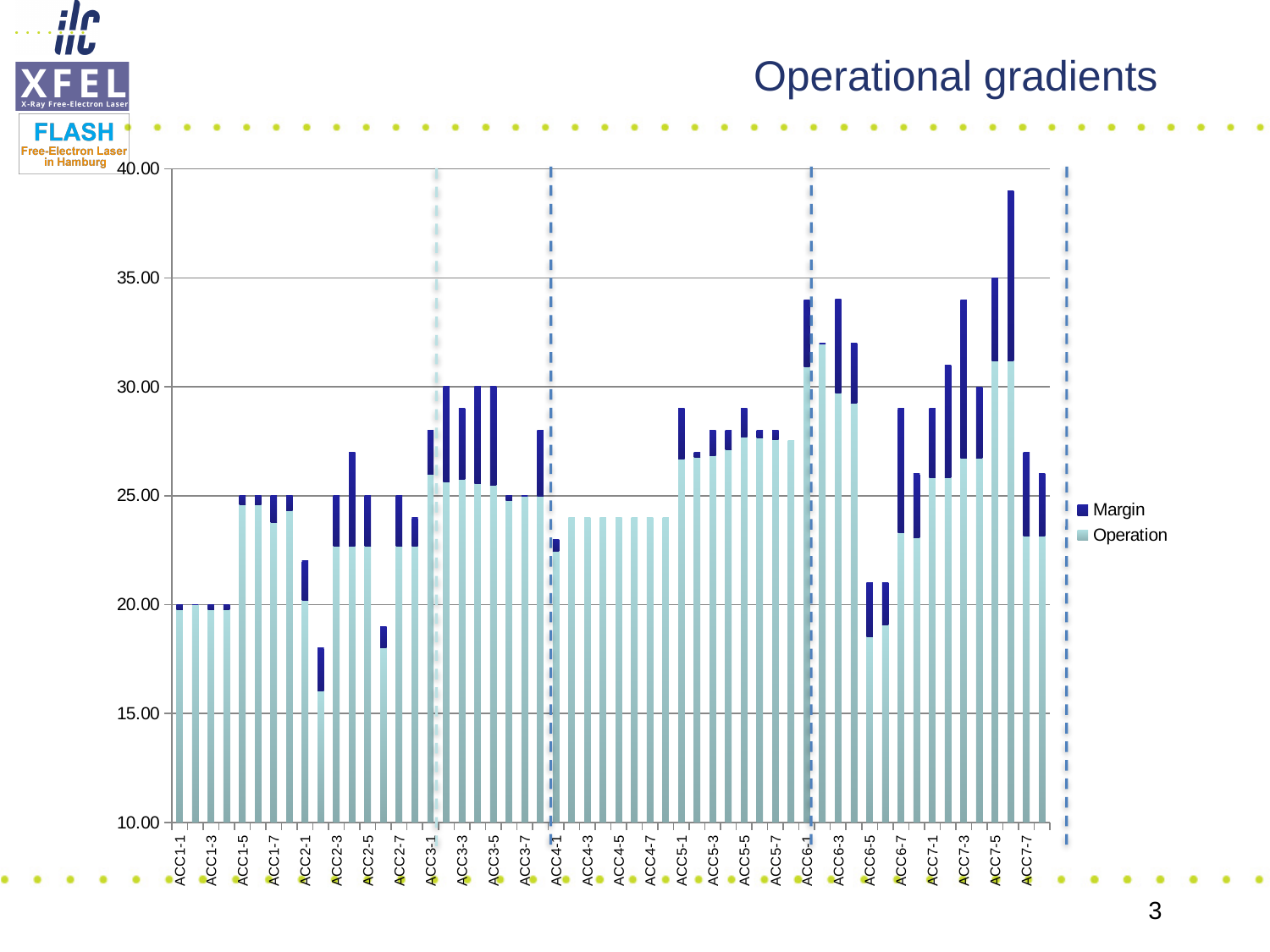
Which has the larger total value, ACC1-1 or ACC3-3? ACC3-3 Is the total value for ACC5-5 greater or less than 30.00? less Which has the larger total value, ACC5-1 or ACC6-5? ACC5-1 Which series is shown in dark blue in the legend? Margin What kind of chart is shown on the slide? Stacked bar chart Which has the larger total value, ACC6-1 or ACC4-3? ACC6-1 How many series does the legend list? 2 Is the total value for ACC4-3 greater or less than 25.00? less What is the title of the chart? Operational gradients Is the total value for ACC2-1 greater or less than 25.00? less